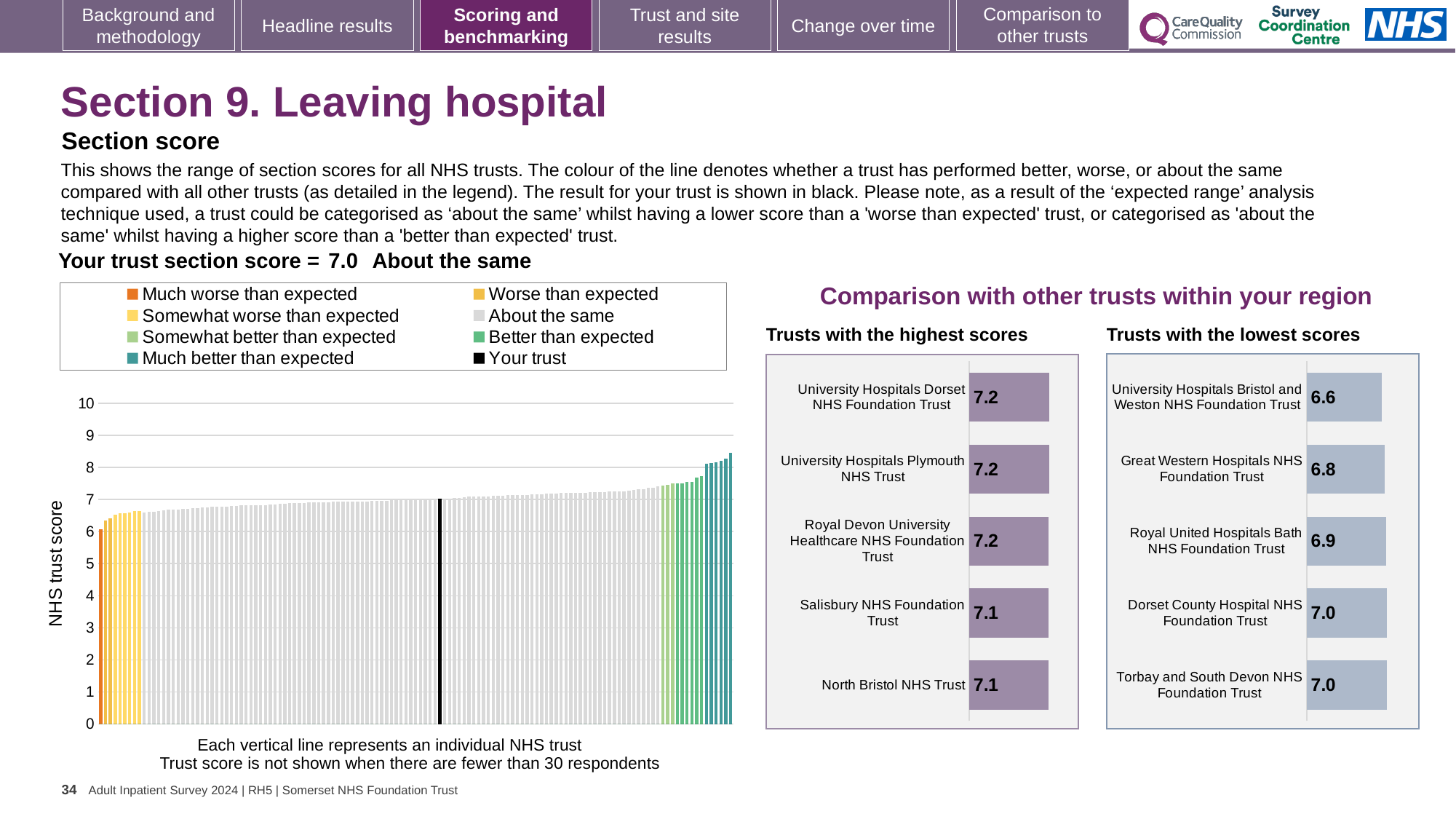
In the main chart of NHS trust scores on the left, do the values rise or fall from left to right along the x axis? rise In the 'Trusts with the highest scores' chart, what is the score for University Hospitals Dorset NHS Foundation Trust? 7.2 In the main chart of NHS trust scores on the left, what is the section score for your trust? 7.0 How many trusts are listed in the 'Trusts with the highest scores' chart? 5 In the 'Trusts with the lowest scores' chart, what is the score for Great Western Hospitals NHS Foundation Trust? 6.8 What kind of chart is the 'Trusts with the lowest scores' chart? bar chart In the 'Trusts with the lowest scores' chart, what is the difference between the scores of Great Western Hospitals NHS Foundation Trust and University Hospitals Bristol and Weston NHS Foundation Trust? 0.2 In the main chart of NHS trust scores on the left, is the value of the highest trust greater or less than 8? greater In the 'Trusts with the highest scores' chart, what is the score for Salisbury NHS Foundation Trust? 7.1 In the 'Trusts with the lowest scores' chart, which trust has the lowest score? University Hospitals Bristol and Weston NHS Foundation Trust In the 'Trusts with the lowest scores' chart, which has the larger score: Royal United Hospitals Bath NHS Foundation Trust or Great Western Hospitals NHS Foundation Trust? Royal United Hospitals Bath NHS Foundation Trust How many entries does the legend of the main chart on the left list? 8